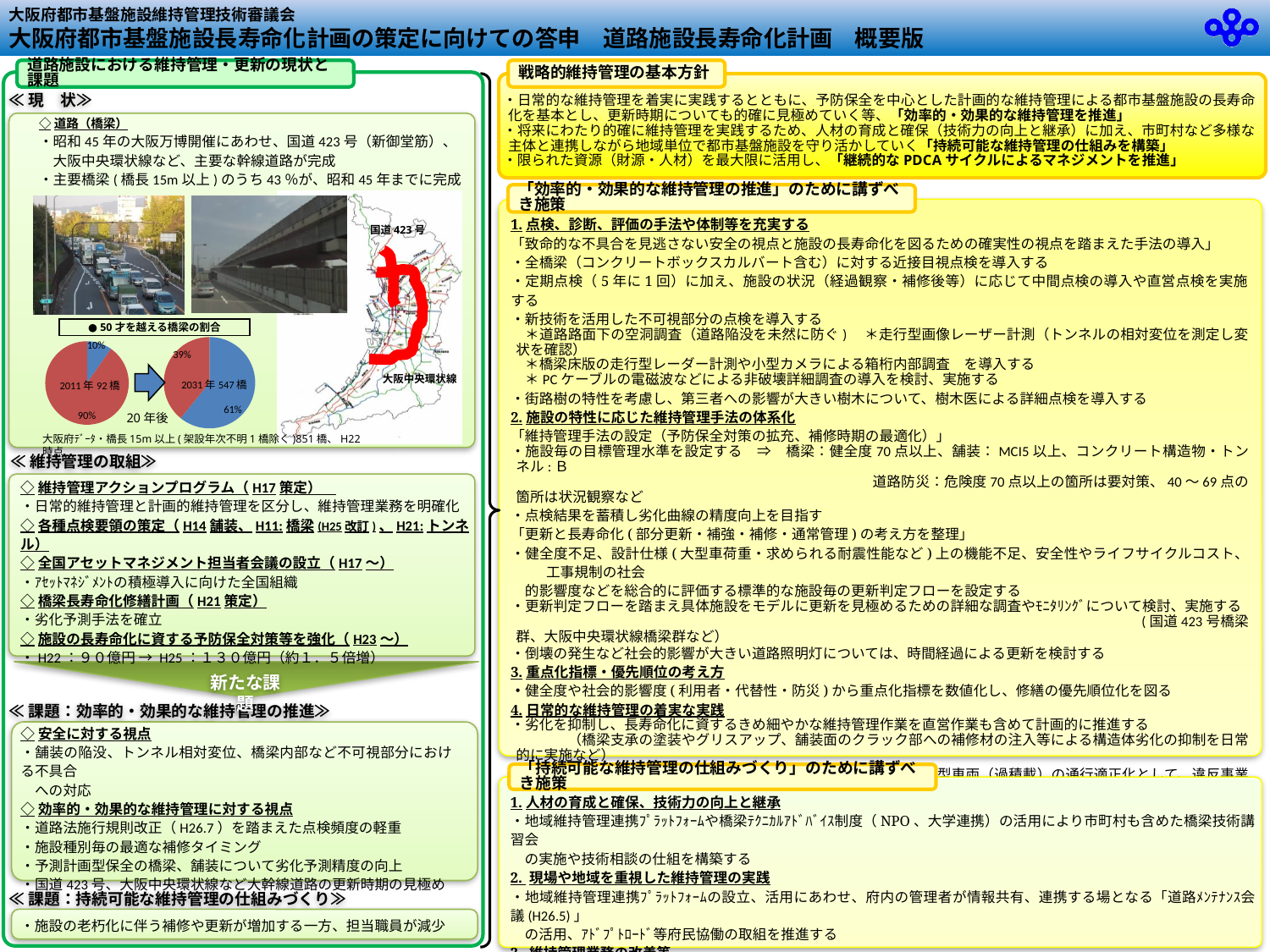
In the 2011年 pie chart, what percentage is shown for the smaller slice? 10% What is the difference in percentage points between the smaller slice of the 2031年 pie (39%) and the smaller slice of the 2011年 pie (10%)? 29 percentage points In the 2011年 pie chart, what percentage is shown for the larger slice? 90% How many bridges are indicated in the label of the 2011年 pie chart? 92橋 In the 2031年 pie chart, what percentage is shown for the larger slice? 61% In the 2031年 pie chart, what percentage is shown for the smaller slice? 39% What text is written next to the arrow between the two pie charts? 20年後 What kind of charts are shown under the heading 「50才を越える橋梁の割合」? Pie charts Which pie chart has the larger smaller-slice percentage, 2011年 or 2031年? 2031年 How many bridges are indicated in the label of the 2031年 pie chart? 547橋 How many slices does the 2011年 pie chart have? 2 What is the title shown above the two pie charts? 50才を越える橋梁の割合